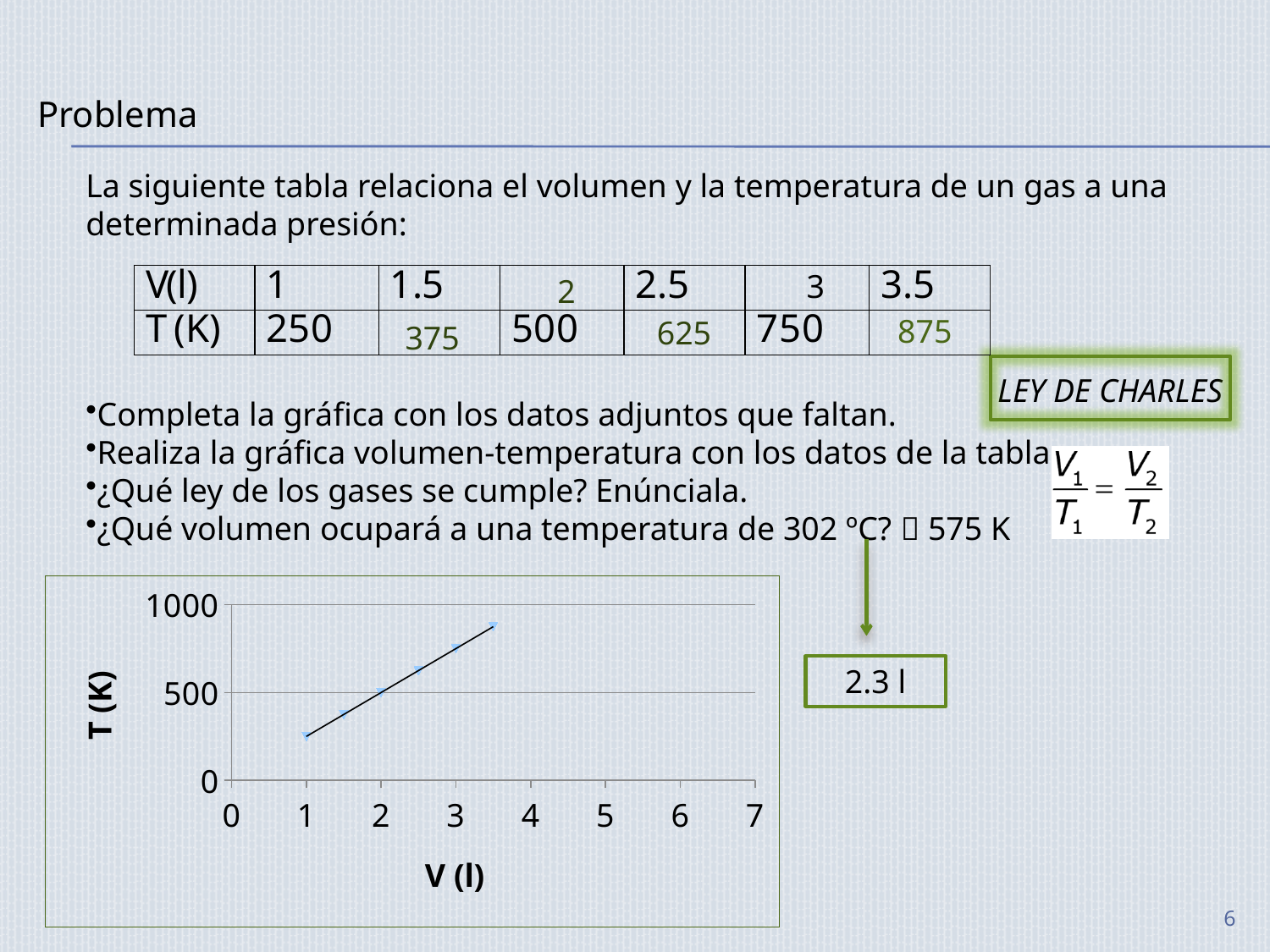
What is the title of the x axis of the chart? V (l) Is the value of T at V = 3.5 greater or less than 500? greater At which V value is the plotted T highest? 3.5 Do the plotted values rise or fall as V increases along the x axis? rise Is the value of T at V = 3 greater or less than 500? greater What is the title of the y axis of the chart? T (K) At which V value is the plotted T lowest? 1 Which has the larger T value: the point at V = 3 or the point at V = 1? V = 3 Is the value of T at V = 1.5 greater or less than 500? less What kind of chart is shown on the slide? line chart How many data points are plotted on the chart? 6